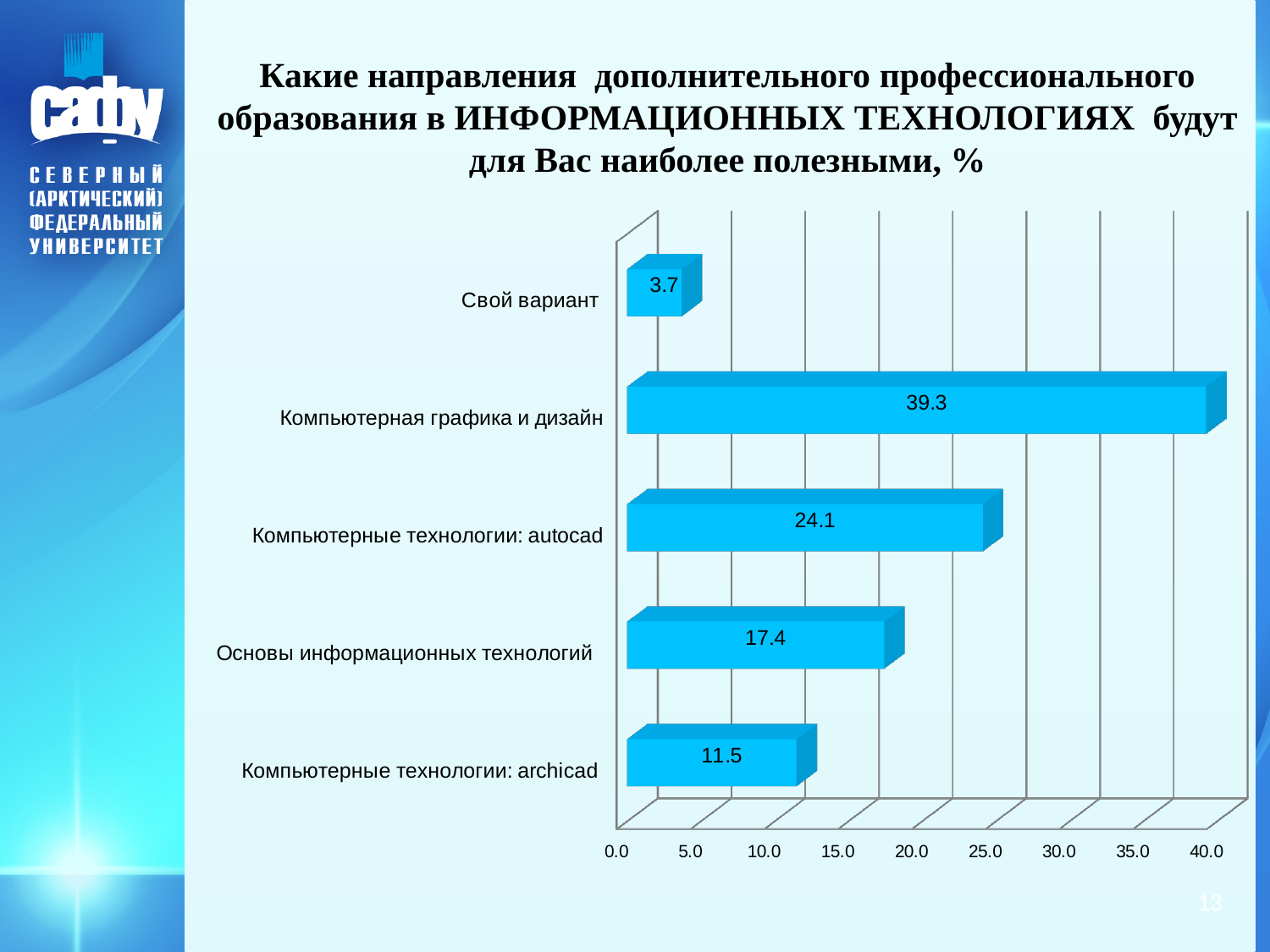
What is the difference between the values for Компьютерная графика и дизайн and Компьютерные технологии: autocad? 15.2 Which category has the highest value? Компьютерная графика и дизайн Is the value for Компьютерные технологии: autocad greater or less than 20.0? greater Which is larger: the value for Основы информационных технологий or the value for Компьютерные технологии: archicad? Основы информационных технологий What kind of chart is shown on the slide? bar chart What is the value for Свой вариант? 3.7 How many categories are shown in the chart? 5 What is the value for Компьютерная графика и дизайн? 39.3 Which category has the lowest value? Свой вариант What is the value for Основы информационных технологий? 17.4 What is the value for Компьютерные технологии: autocad? 24.1 What is the value for Компьютерные технологии: archicad? 11.5